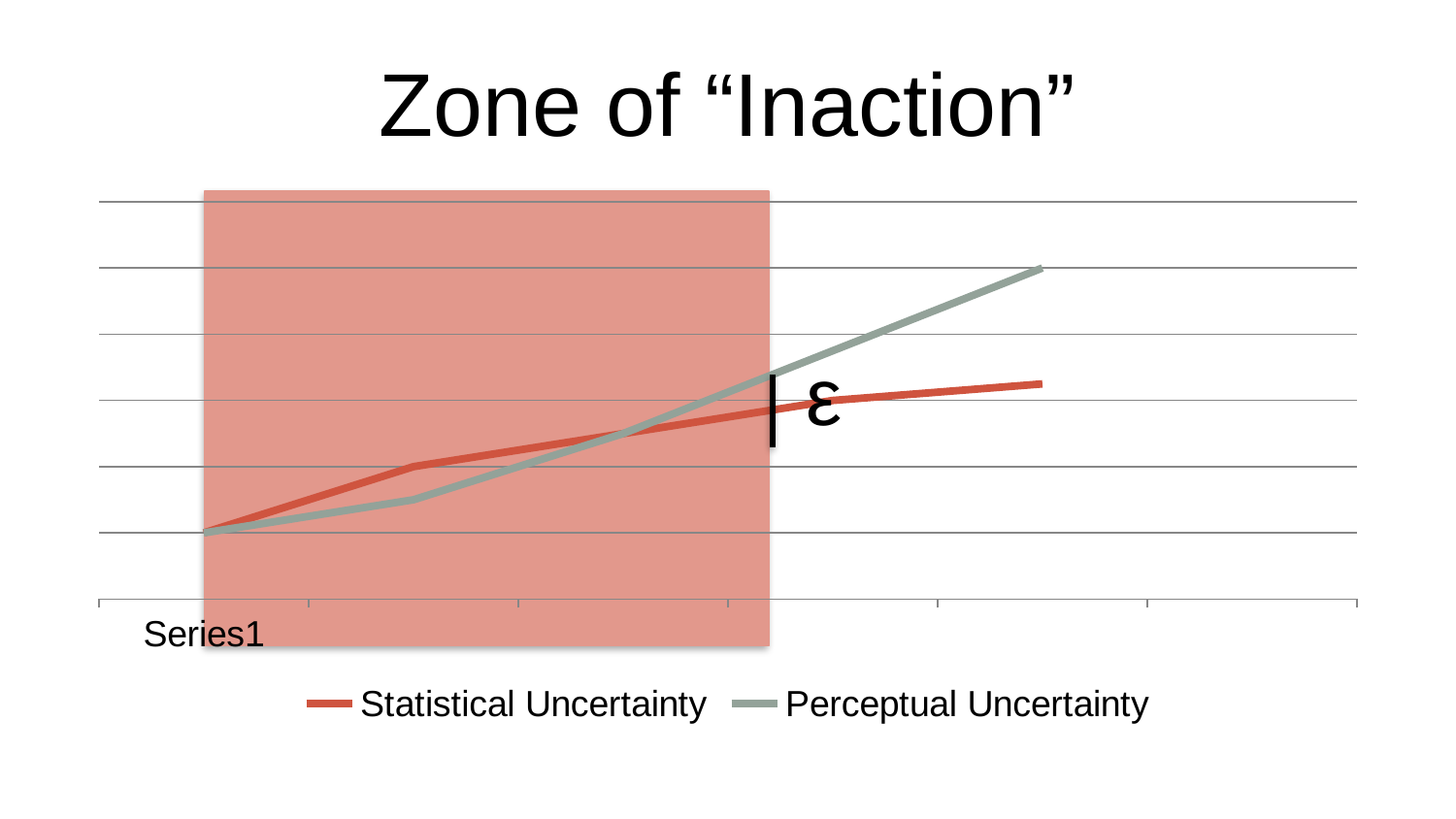
What kind of chart is shown on the slide? line chart Which series reaches the highest value on the chart? Perceptual Uncertainty How many series does the legend list? 2 Does the Perceptual Uncertainty line rise or fall from left to right? rise Which series is drawn in red? Statistical Uncertainty Does the Statistical Uncertainty line rise or fall from left to right? rise What is the title of the chart on the slide? Zone of "Inaction" At the second point from the left, which series has the higher value, Statistical Uncertainty or Perceptual Uncertainty? Statistical Uncertainty At the right end of the chart, which series has the higher value, Statistical Uncertainty or Perceptual Uncertainty? Perceptual Uncertainty